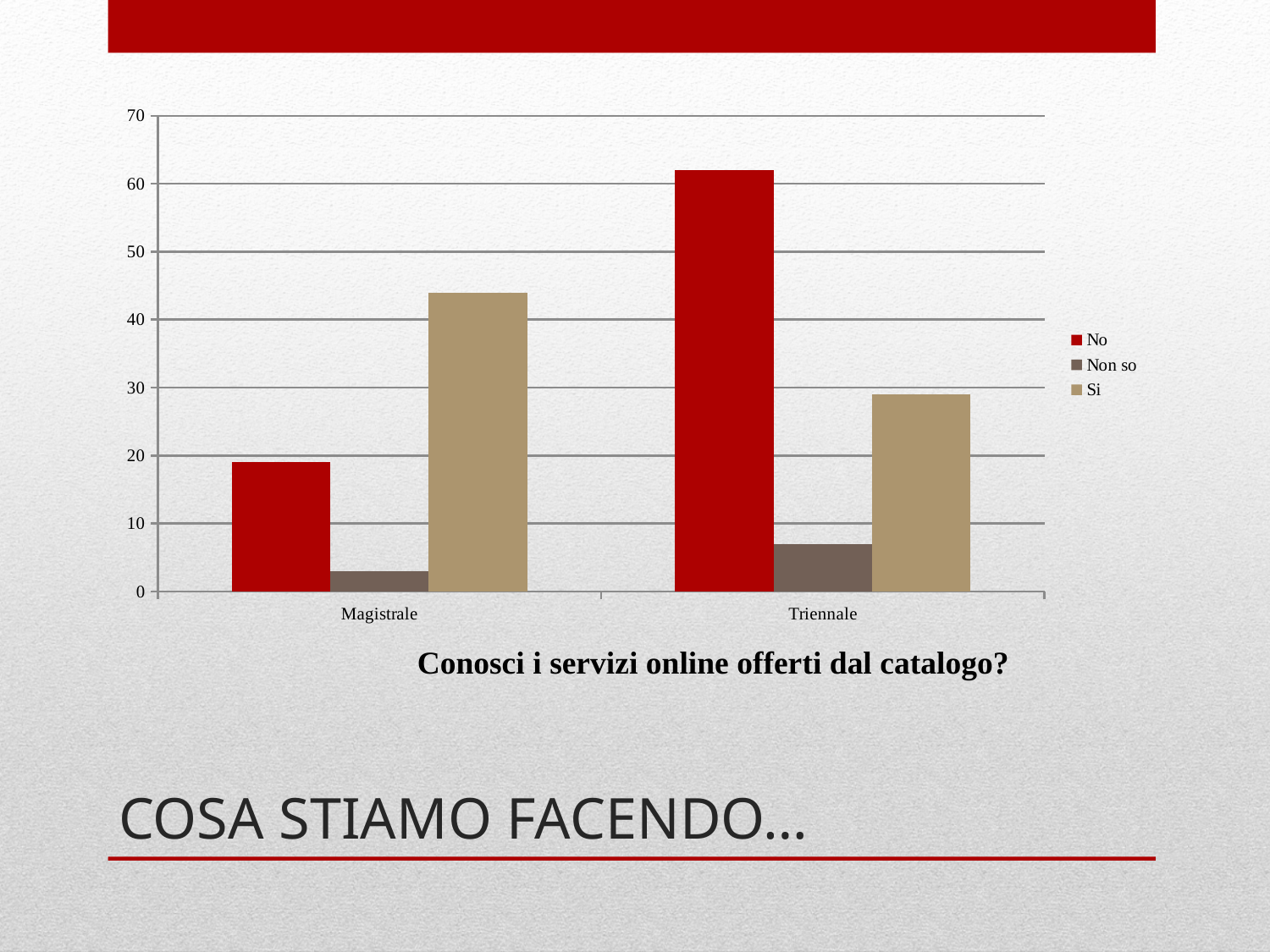
Is the value for Si in Magistrale greater or less than 40? greater Which series has the highest value for Magistrale? Si How many series does the legend list? 3 Which series has the highest value for Triennale? No Which is larger, the Si value for Magistrale or the Si value for Triennale? Magistrale What is the title of the chart? Conosci i servizi online offerti dal catalogo? What kind of chart is shown on the slide? bar chart Which series is shown in red in the legend? No How many categories are shown on the x axis? 2 Which series has the lowest value for Magistrale? Non so Is the value for Non so in Triennale greater or less than 10? less Is the value for No in Triennale greater or less than 60? greater